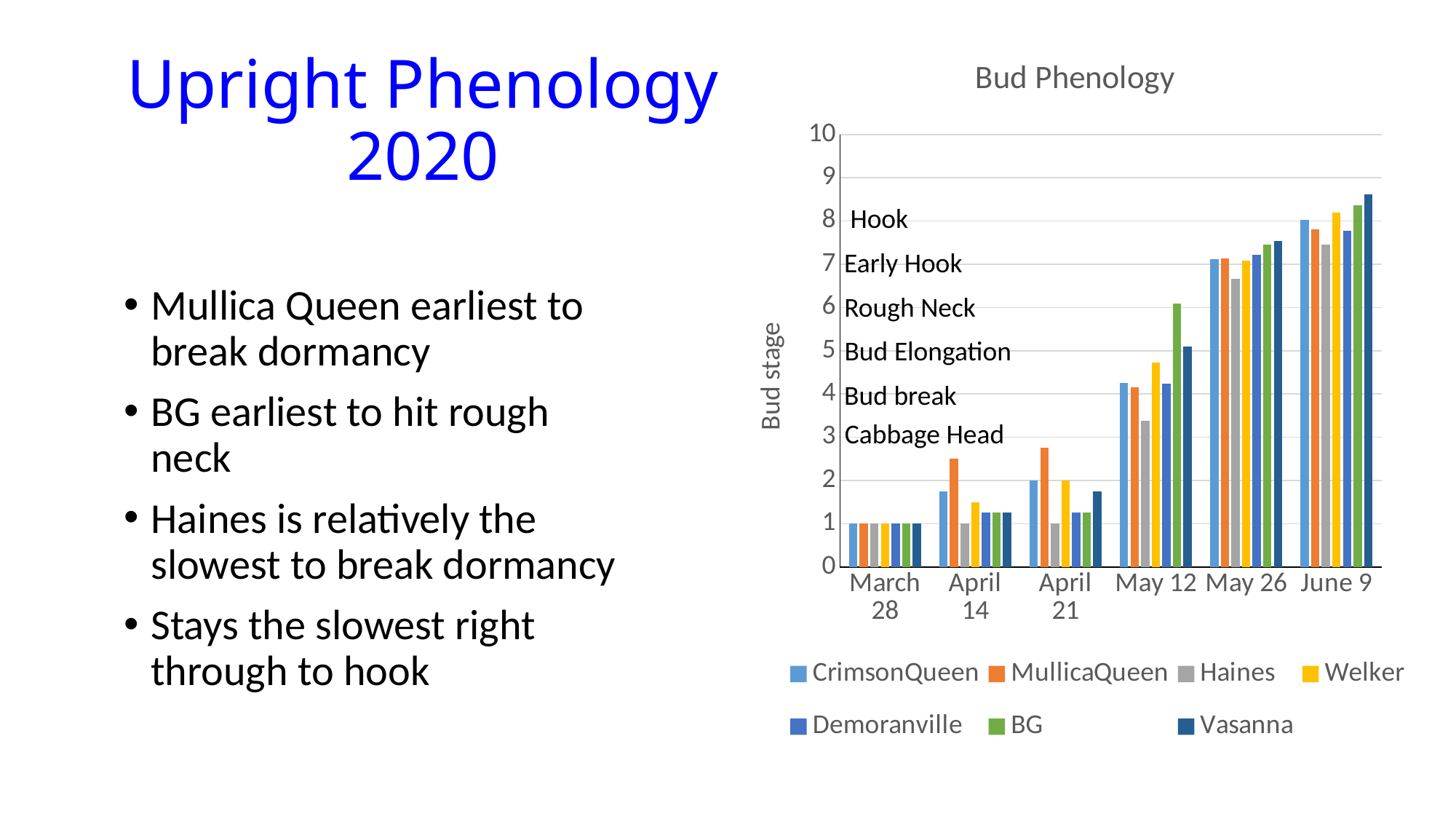
What is the bud stage value for CrimsonQueen on April 21? 2 What is the bud stage value for Haines on March 28? 1 How many series does the chart legend list? 7 Do the bud stage values generally rise or fall from March 28 to June 9? rise Which series has the highest bud stage on May 12? BG How many dates are shown along the x axis of the chart? 6 What is the label of the vertical axis? Bud stage Which series has the lowest bud stage on May 12? Haines What kind of chart is shown on the slide? bar chart What is the title of the chart? Bud Phenology Is the bud stage value for MullicaQueen on April 14 greater or less than 2? greater